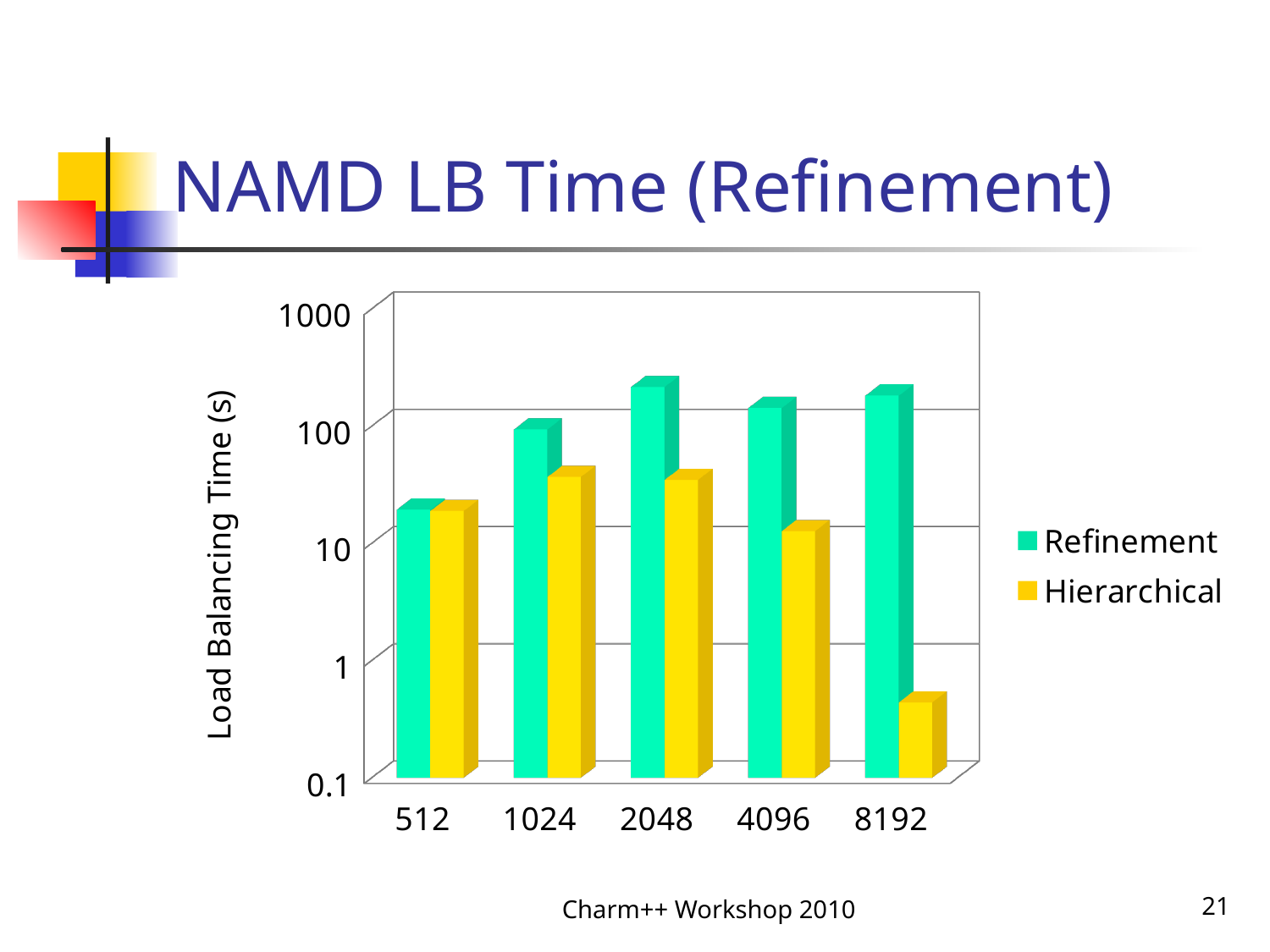
What is the label of the y axis? Load Balancing Time (s) Is the Refinement value at 2048 greater or less than 100? greater What kind of chart is shown on the slide? bar chart For which category is the Hierarchical value lowest? 8192 Is the Refinement value at 512 greater or less than 100? less Which series is shown in yellow? Hierarchical How many categories are shown on the x axis? 5 Is the Hierarchical value at 1024 greater or less than 10? greater How many series does the legend list? 2 At 8192, which series has the larger value, Refinement or Hierarchical? Refinement Do the Hierarchical values rise or fall from 1024 to 8192? fall